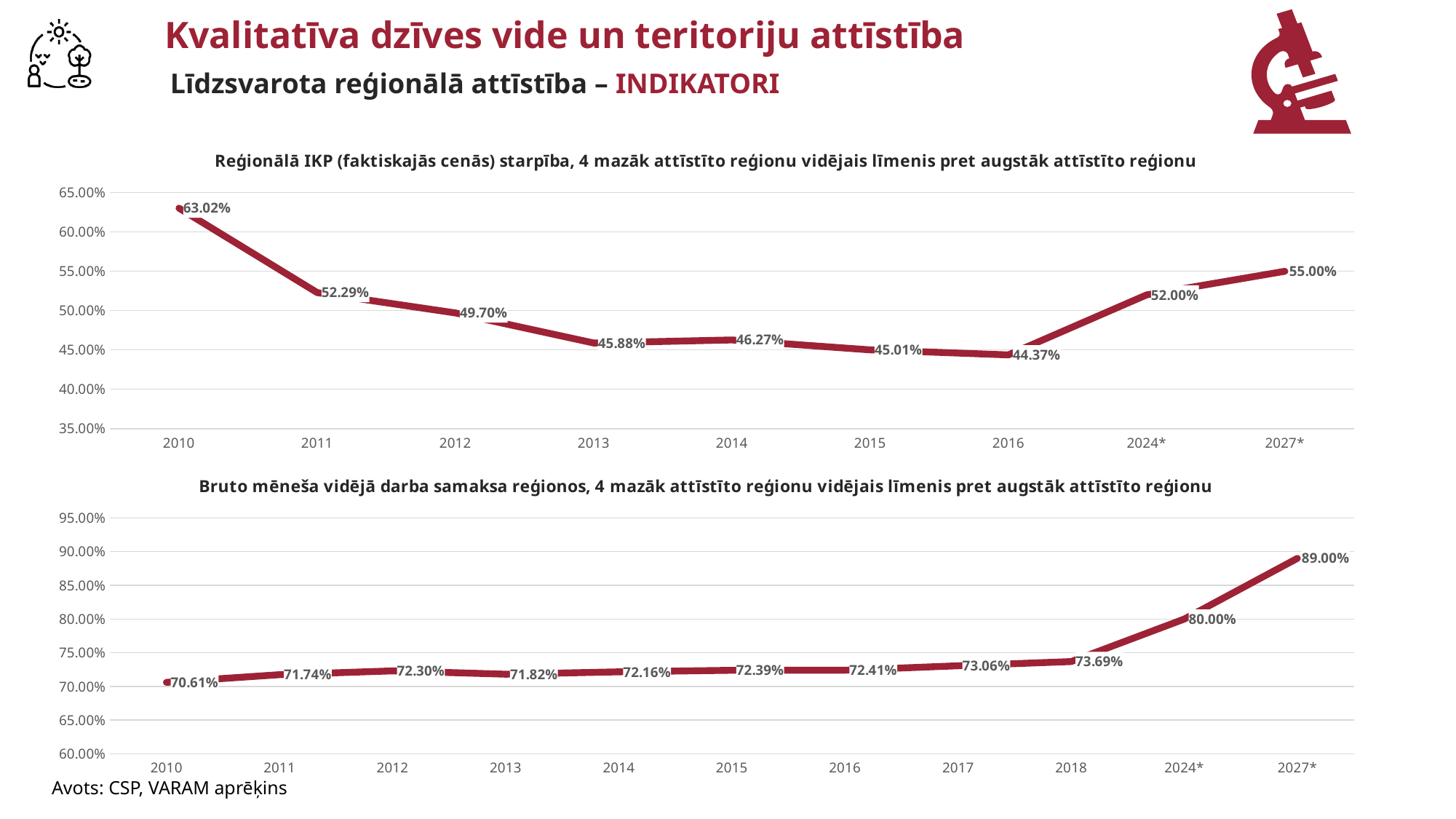
What type of chart is the top chart on the slide? line chart In the bottom chart (Bruto mēneša vidējā darba samaksa), which is larger, the value for 2012 or the value for 2013? 2012 In the top chart (Reģionālā IKP starpība), do the values rise or fall from 2010 to 2016? fall In the top chart (Reģionālā IKP starpība), which year has the lowest value? 2016 In the top chart (Reģionālā IKP starpība), how many data points are plotted? 9 In the top chart (Reģionālā IKP starpība), what is the value for 2010? 63.02% In the bottom chart (Bruto mēneša vidējā darba samaksa), how many data points are plotted? 11 In the bottom chart (Bruto mēneša vidējā darba samaksa), what is the value for 2018? 73.69% In the bottom chart (Bruto mēneša vidējā darba samaksa), which year has the highest value? 2027* In the bottom chart (Bruto mēneša vidējā darba samaksa), what is the value for 2027*? 89.00% In the top chart (Reģionālā IKP starpība), what is the value for 2016? 44.37% In the top chart (Reģionālā IKP starpība), what is the difference between the 2010 value and the 2011 value? 10.73%